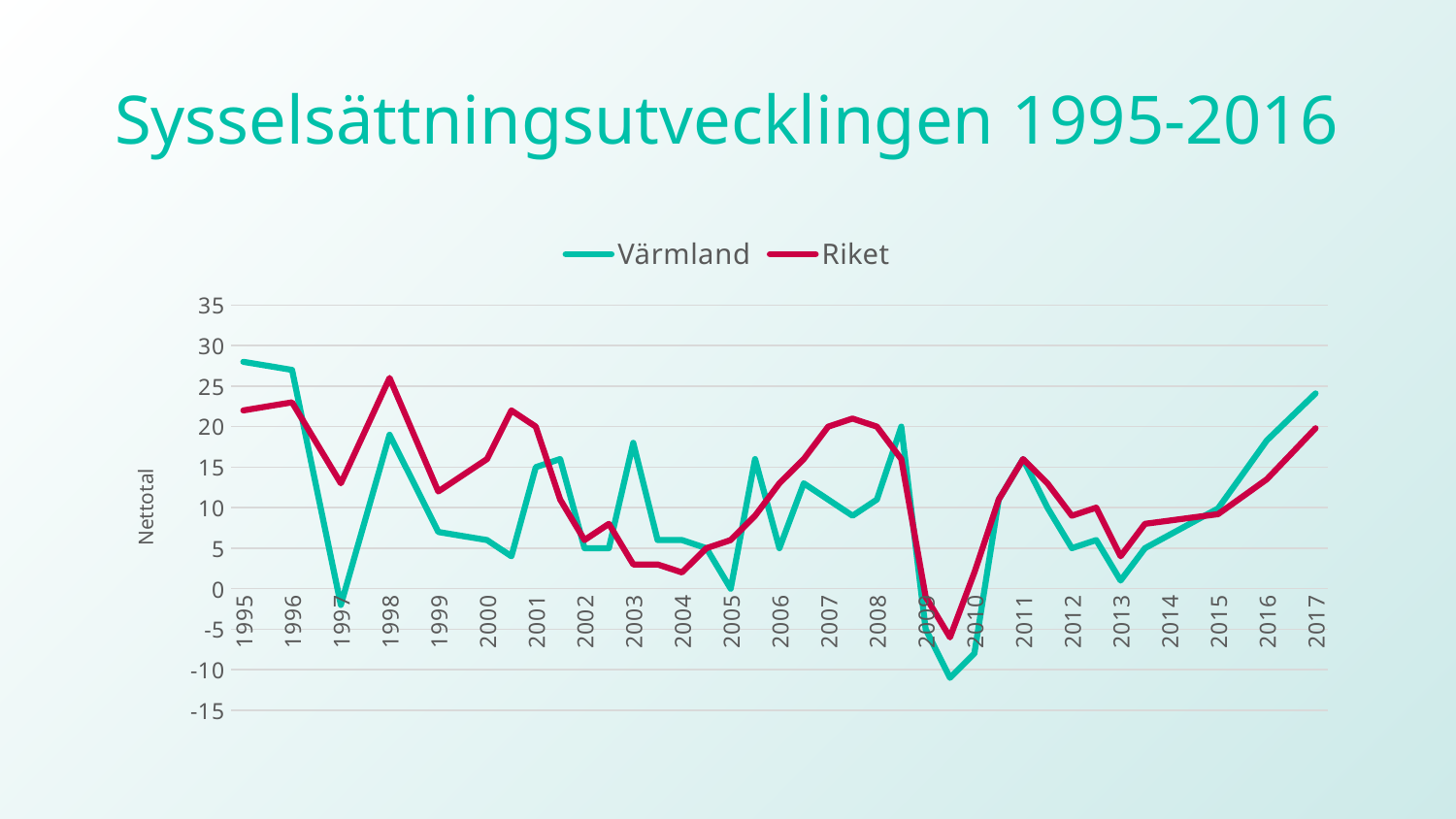
What kind of chart is shown on the slide? line chart Is the value for Riket at 1995 greater or less than 20? greater Which two series are shown in the legend? Värmland and Riket Which series reaches the lowest value anywhere on the chart? Värmland What is the label on the vertical axis? Nettotal Is the value for Värmland at 1995 greater or less than 25? greater Do the values for Värmland rise or fall from 2013 to 2017? rise Which series has the higher value at 1995? Värmland Is the value for Värmland at 2017 greater or less than 20? greater How many year labels are shown along the x axis? 23 Which series has the higher value at its 1998 peak? Riket How many series does the legend list? 2